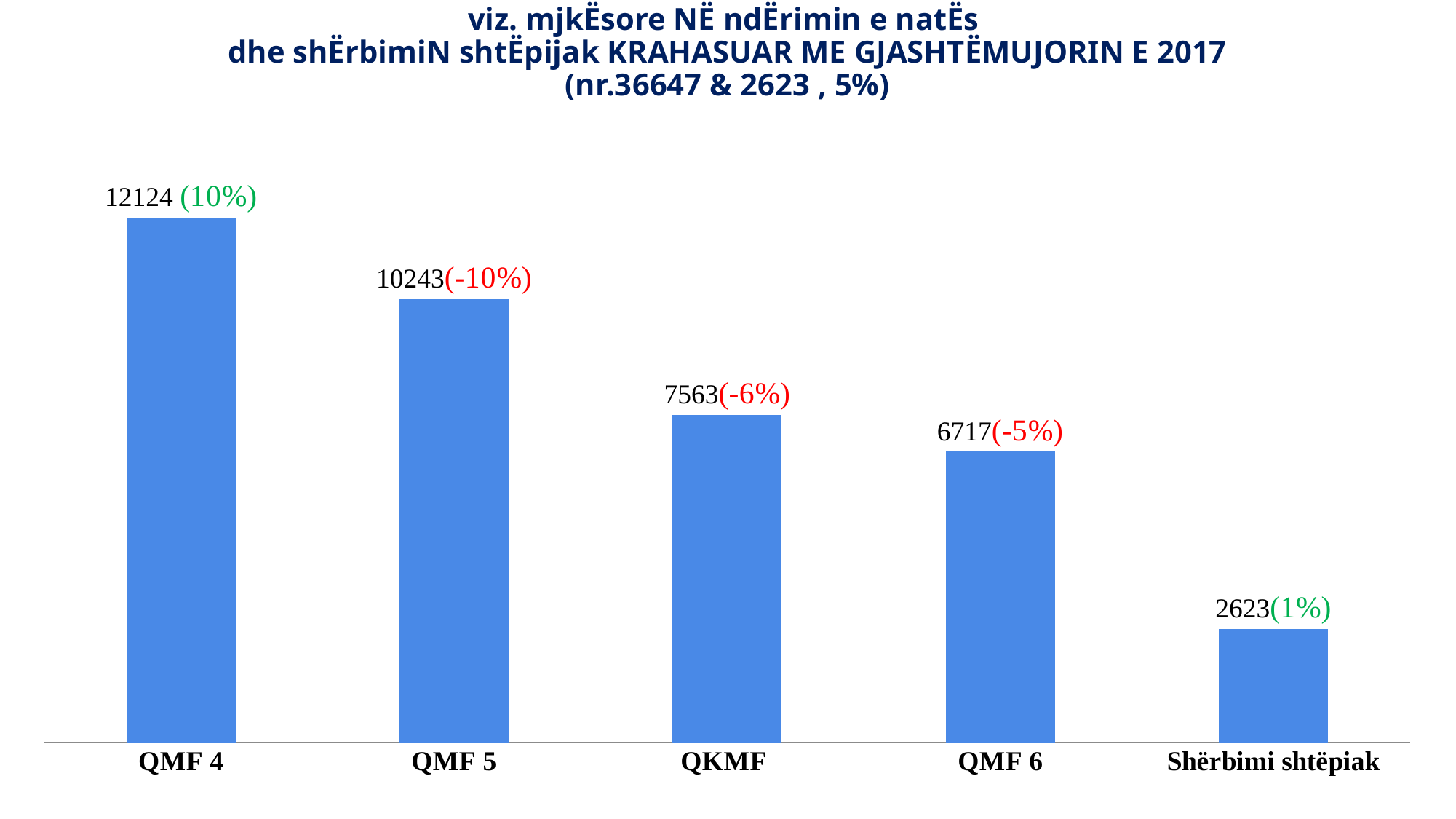
Which category has the lowest value? Shërbimi shtëpiak What percentage change is shown next to the value for QMF 5? -10% What is the value for QMF 4? 12124 How many categories are shown on the x axis? 5 What is the value for QKMF? 7563 What is the value for QMF 5? 10243 What is the difference between the values for QMF 4 and QMF 5? 1881 What kind of chart is this? Bar chart Which category has the highest value? QMF 4 What is the value for QMF 6? 6717 Which is larger, the value for QKMF or the value for QMF 6? QKMF What is the value for Shërbimi shtëpiak? 2623